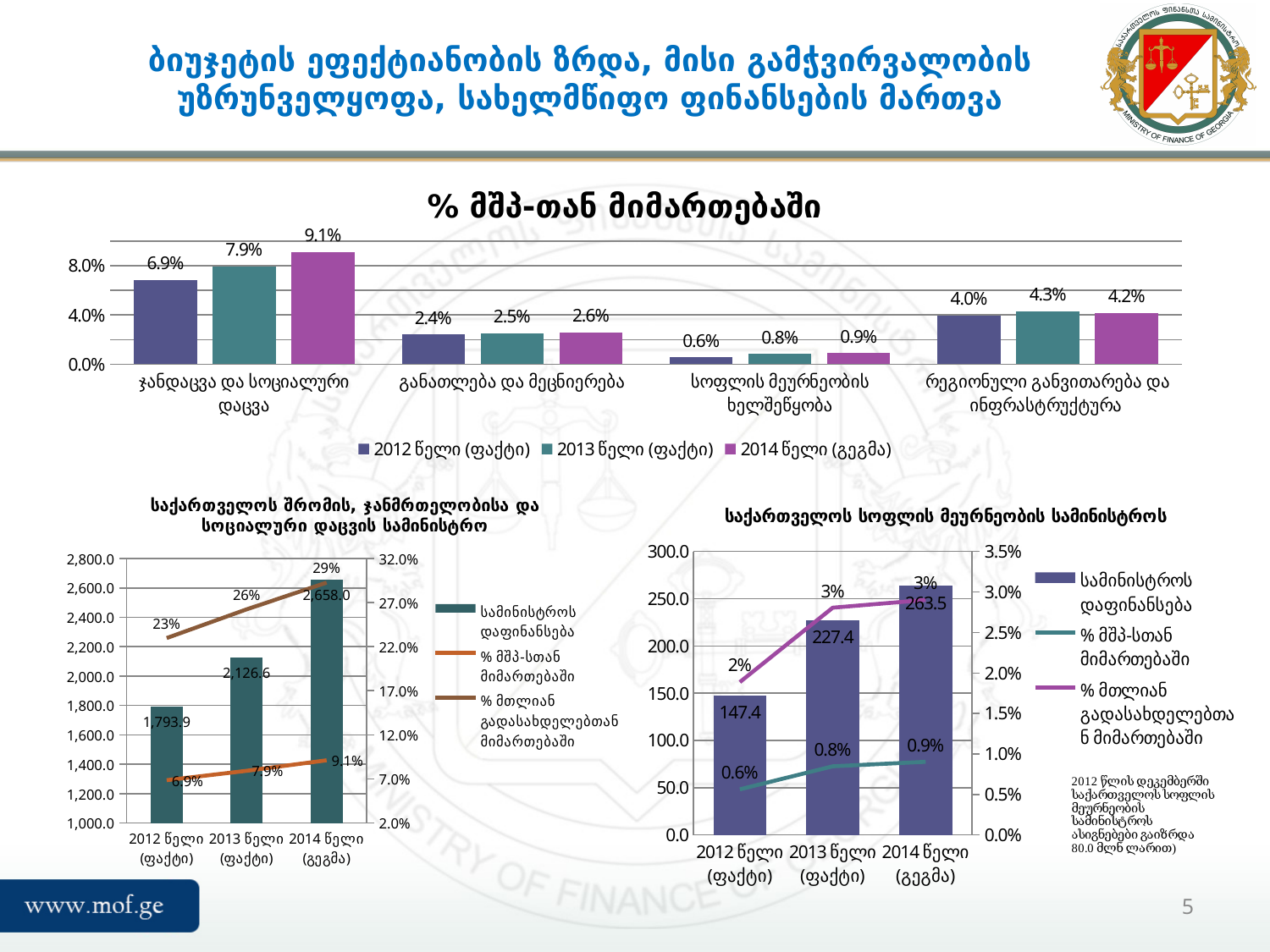
In the top chart '% მშპ-თან მიმართებაში', which category has the lowest value in the 2014 წელი (გეგმა) series? სოფლის მეურნეობის ხელშეწყობა In the top chart '% მშპ-თან მიმართებაში', which category has the highest value in the 2013 წელი (ფაქტი) series? ჯანდაცვა და სოციალური დაცვა In the top chart '% მშპ-თან მიმართებაში', how many series does the legend list? 3 In the top chart '% მშპ-თან მიმართებაში', how many categories are shown on the x axis? 4 In the bottom-left chart 'საქართველოს შრომის, ჯანმრთელობისა და სოციალური დაცვის სამინისტრო', what is the % მთლიან გადასახდელებთან მიმართებაში value for 2012 წელი (ფაქტი)? 23% In the bottom-right chart 'საქართველოს სოფლის მეურნეობის სამინისტრო', what is the სამინისტროს დაფინანსება value for 2013 წელი (ფაქტი)? 227.4 In the top chart '% მშპ-თან მიმართებაში', what is the value for ჯანდაცვა და სოციალური დაცვა in the 2014 წელი (გეგმა) series? 9.1% In the top chart '% მშპ-თან მიმართებაში', what is the 2012 წელი (ფაქტი) value for სოფლის მეურნეობის ხელშეწყობა? 0.6% In the bottom-left chart 'საქართველოს შრომის, ჯანმრთელობისა და სოციალური დაცვის სამინისტრო', what is the სამინისტროს დაფინანსება value for 2014 წელი (გეგმა)? 2,658.0 In the bottom-right chart 'საქართველოს სოფლის მეურნეობის სამინისტრო', what is the difference in სამინისტროს დაფინანსება between 2014 წელი (გეგმა) and 2012 წელი (ფაქტი)? 116.1 In the top chart '% მშპ-თან მიმართებაში', do the values for რეგიონული განვითარება და ინფრასტრუქტურა rise or fall from 2013 წელი (ფაქტი) to 2014 წელი (გეგმა)? fall In the top chart '% მშპ-თან მიმართებაში', what is the difference between the 2014 წელი (გეგმა) and 2012 წელი (ფაქტი) values for ჯანდაცვა და სოციალური დაცვა? 2.2%